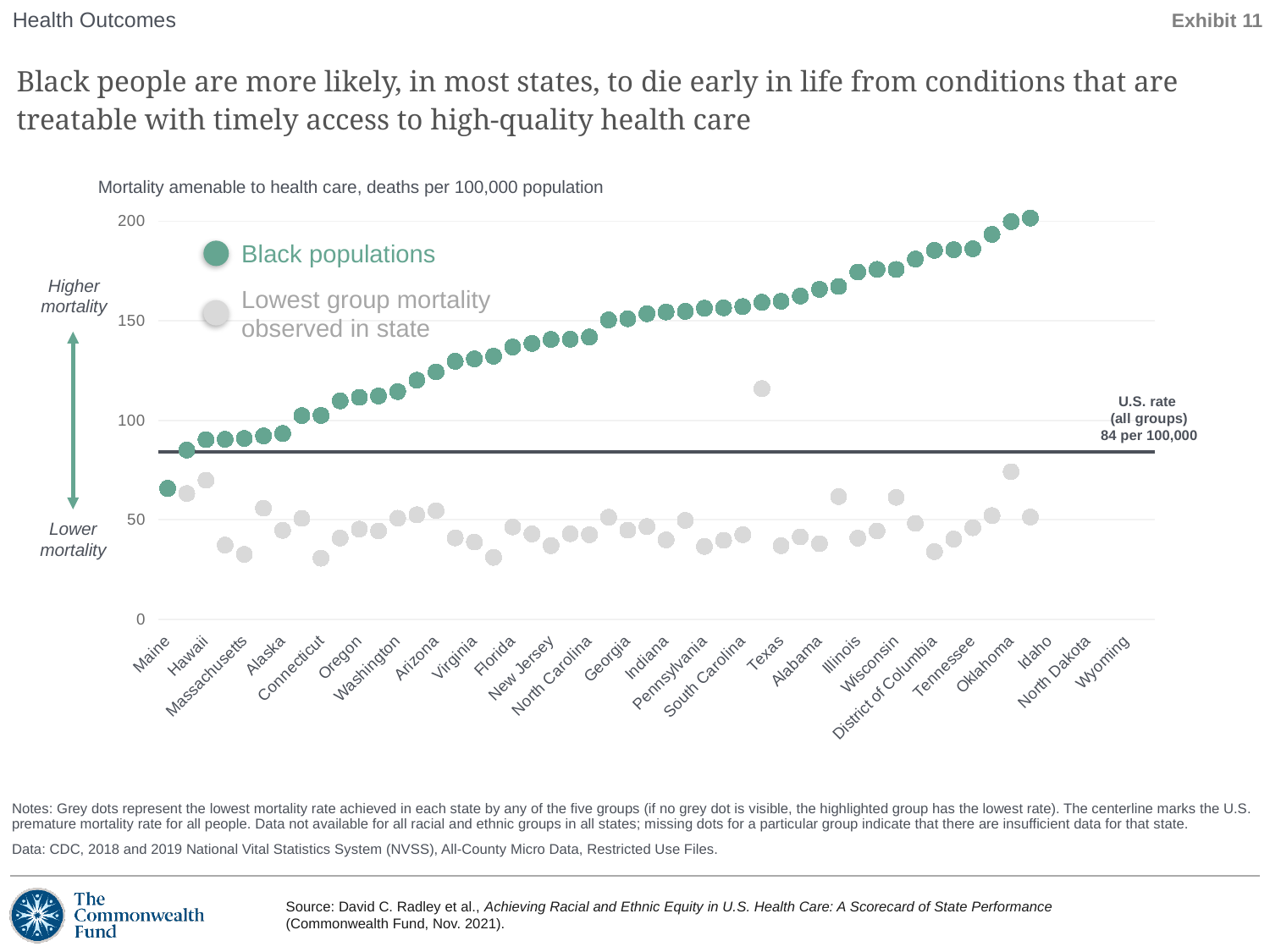
What is the U.S. rate (all groups) marked by the centerline? 84 per 100,000 Is the Black populations value for Maine greater or less than 100? less How many series does the legend list? 2 Do the Black populations values rise or fall moving from left to right along the x axis? Rise Which state has the lowest mortality value for Black populations? Maine What are the two series named in the legend? Black populations; Lowest group mortality observed in state What does the y axis measure, according to the chart subtitle? Mortality amenable to health care, deaths per 100,000 population What kind of chart is shown on the slide? Dot plot (scatter chart) Is the U.S. rate centerline above or below the 100 gridline? below